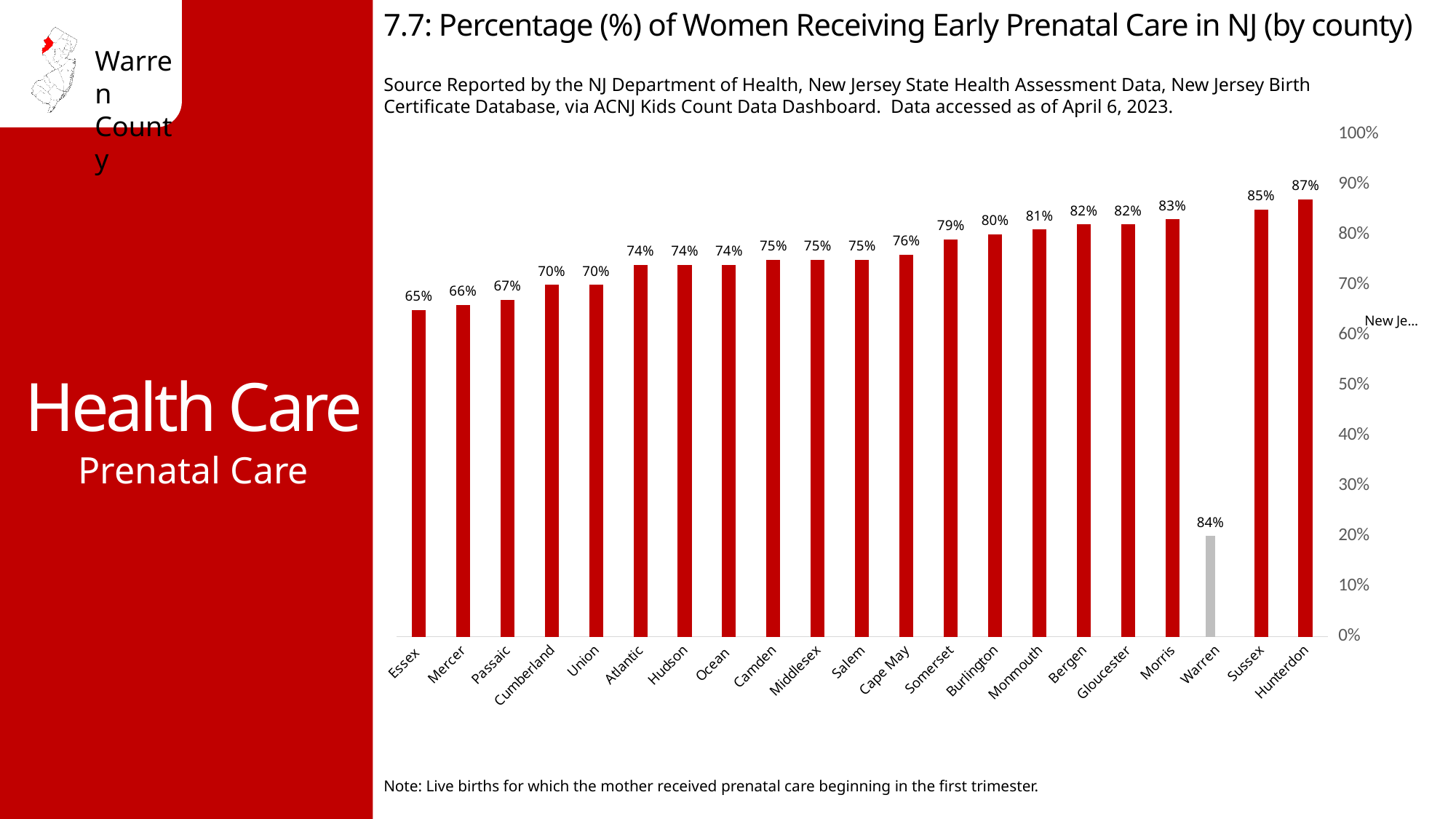
What is the value for Somerset? 79% What is the value for Essex? 65% Which county's bar is shown in gray instead of red? Warren Which has a higher value, Bergen or Cumberland? Bergen Which county has the highest percentage of women receiving early prenatal care? Hunterdon Is the value for Morris greater or less than 80%? greater What is the difference between the values for Hunterdon and Essex? 22 percentage points Do the labelled values generally rise or fall from left to right along the x axis? rise What value is labelled for Warren? 84% What kind of chart is shown on the slide? bar chart How many counties are shown on the x axis? 21 What is the value for Hunterdon? 87%